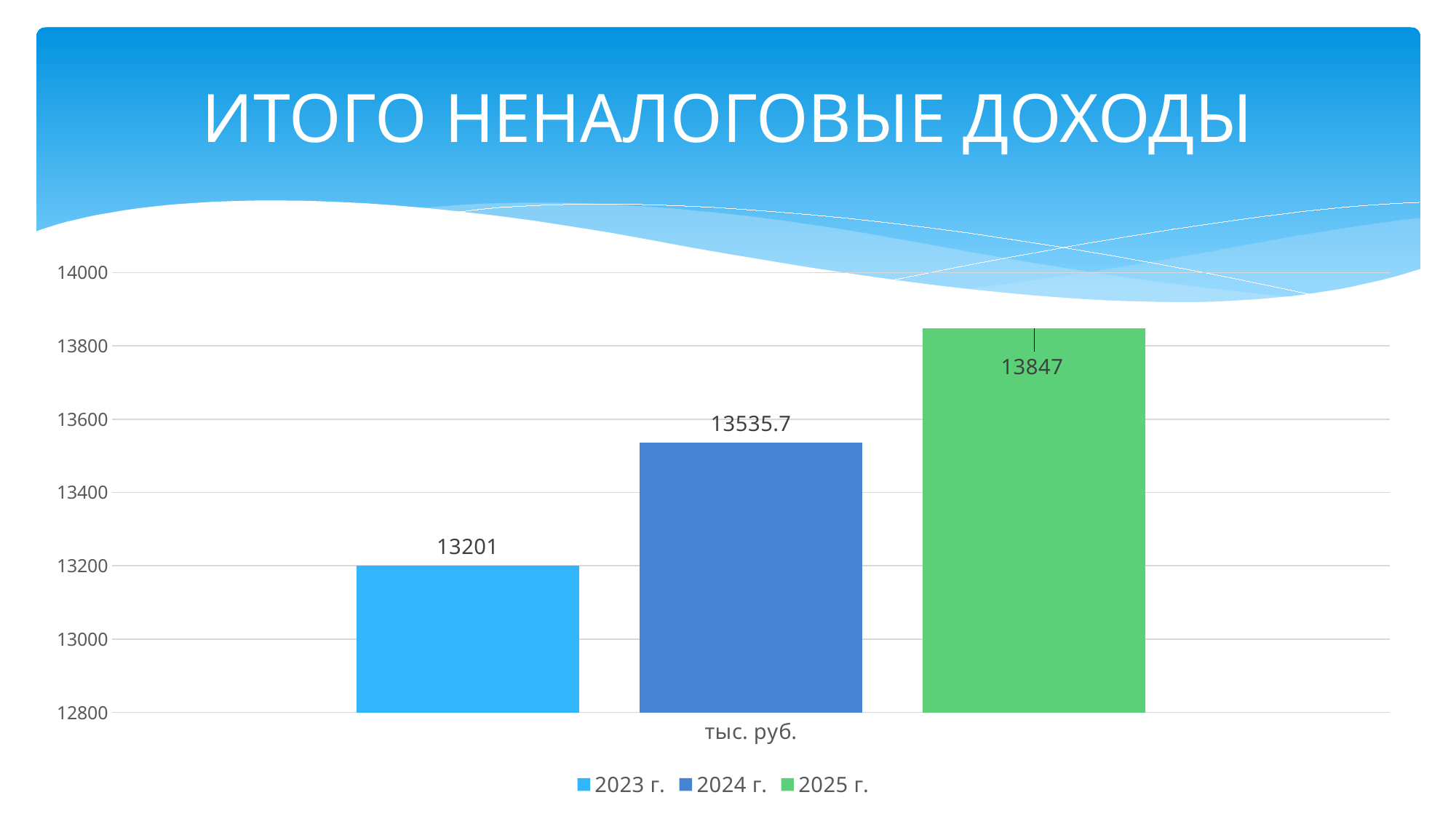
Which year has the highest value? 2025 г. Which year has the lowest value? 2023 г. Is the value for 2025 г. greater or less than 13800? greater What is the value for 2025 г.? 13847 What kind of chart is shown on the slide? bar chart What is the value for 2023 г.? 13201 What is the difference between the values for 2024 г. and 2023 г.? 334.7 Which is larger, the value for 2024 г. or the value for 2025 г.? 2025 г. What is the title of the slide? ИТОГО НЕНАЛОГОВЫЕ ДОХОДЫ What is the difference between the values for 2025 г. and 2023 г.? 646 What is the value for 2024 г.? 13535.7 How many series does the legend list? 3